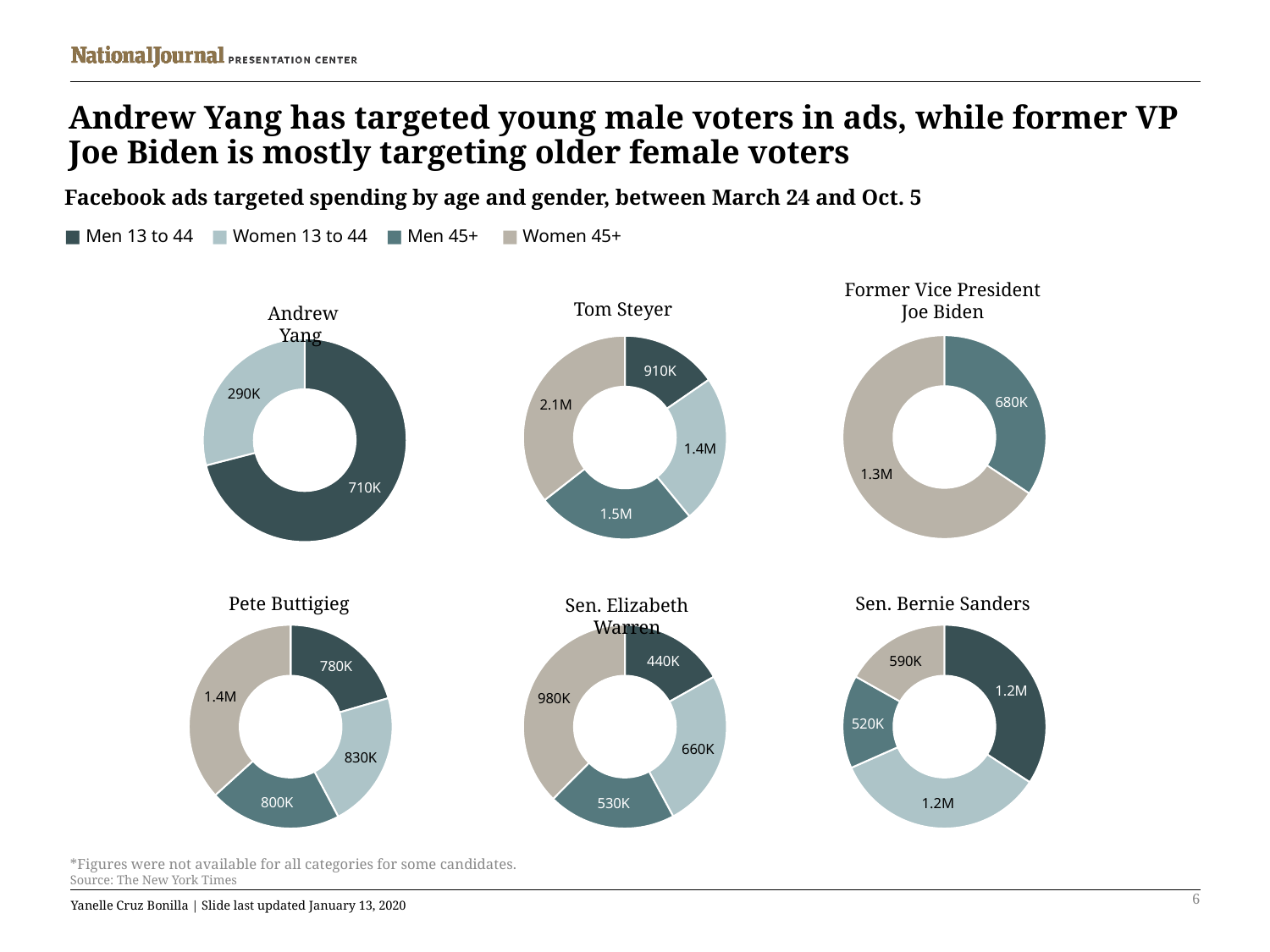
In the Andrew Yang chart, what is the difference between Men 13 to 44 and Women 13 to 44? 420K In the Former Vice President Joe Biden chart, what is the value for Men 45+? 680K How many categories does the legend list? 4 In the Tom Steyer chart, which category has the highest value? Women 45+ In the Sen. Bernie Sanders chart, what is the value for Men 45+? 520K In the Sen. Elizabeth Warren chart, what is the difference between Women 45+ and Men 13 to 44? 540K In the Tom Steyer chart, what is the value for Women 45+? 2.1M In the Andrew Yang chart, what is the value for Men 13 to 44? 710K In the Sen. Elizabeth Warren chart, which category has the lowest value? Men 13 to 44 In the Pete Buttigieg chart, which is larger: Women 45+ or Men 45+? Women 45+ How many donut charts are shown on the slide? 6 What type of chart is used for each candidate on the slide? Donut (pie) chart